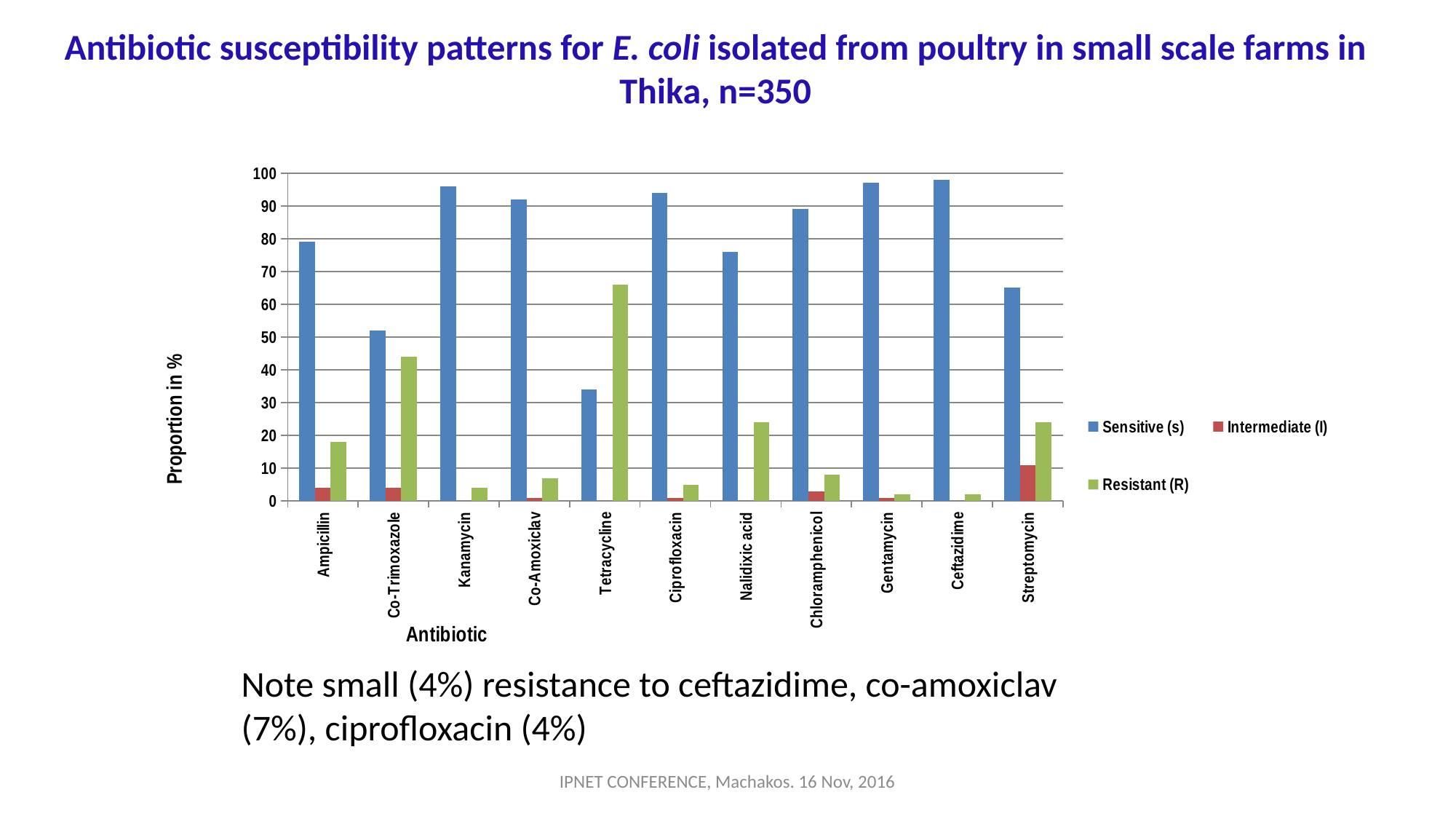
How many series does the chart legend list? 3 Which antibiotic has the highest Intermediate (I) proportion? Streptomycin What kind of chart is shown on the slide? bar chart How many antibiotics are shown on the x axis of the chart? 11 Which antibiotic has the highest Resistant (R) proportion? Tetracycline Is the Sensitive (s) value for Streptomycin greater or less than 70? less Which antibiotic has the lowest Sensitive (s) proportion? Tetracycline What is the label of the y axis of the chart? Proportion in % Which has the larger Resistant (R) value, Co-Trimoxazole or Ampicillin? Co-Trimoxazole Is the Sensitive (s) value for Ampicillin greater or less than 70? greater Is the Sensitive (s) value for Co-Trimoxazole greater or less than 60? less